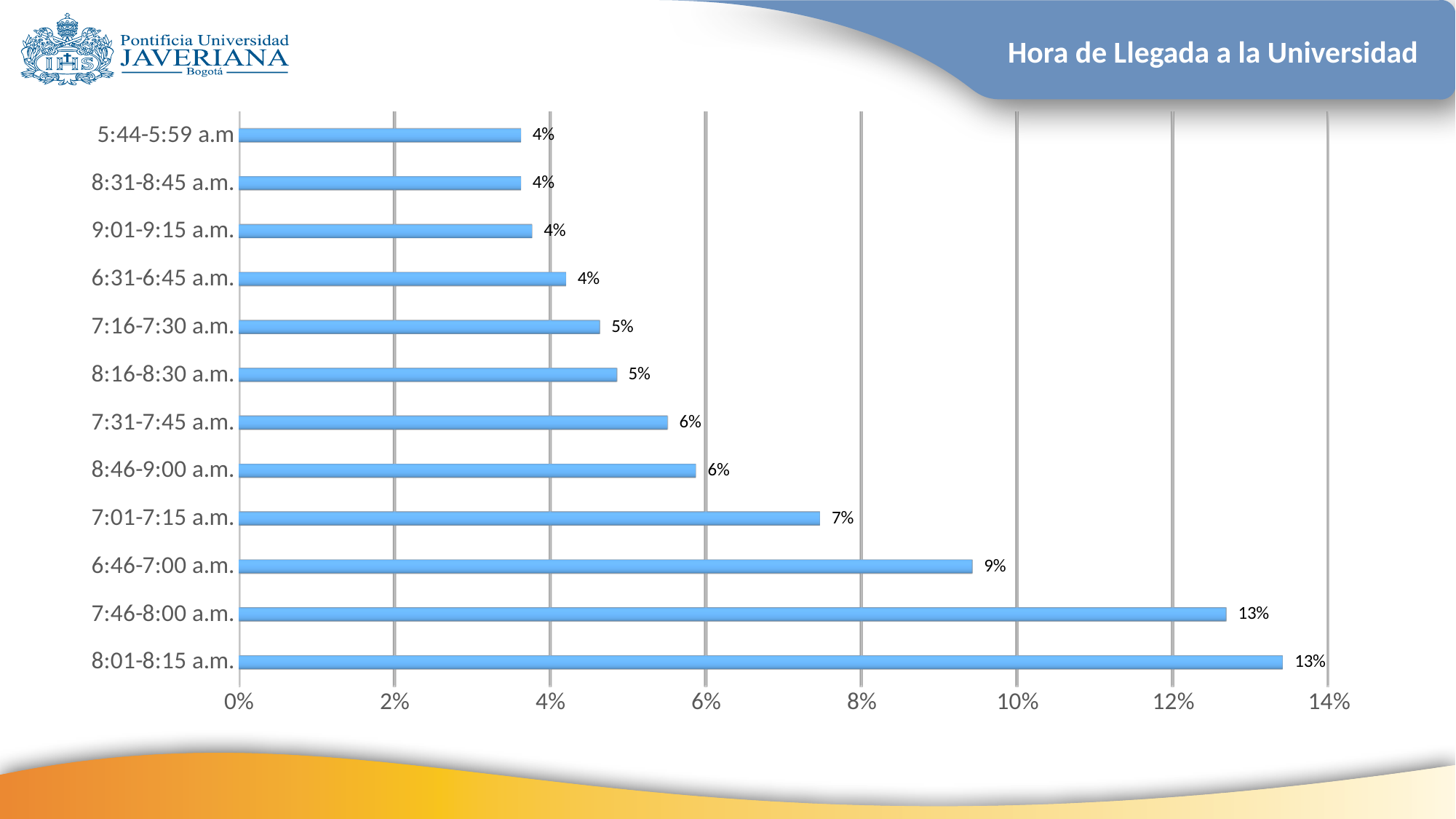
What is the value for 8:16-8:30 a.m.? 5% Is the value for 7:46-8:00 a.m. greater or less than 12%? greater What is the difference between the values for 6:46-7:00 a.m. and 7:01-7:15 a.m.? 2% What is the value for 7:31-7:45 a.m.? 6% How many time-interval categories are shown on the chart? 12 What kind of chart is shown on the slide? bar chart What is the value for 8:01-8:15 a.m.? 13% What is the value for 5:44-5:59 a.m? 4% What is the title shown on the slide for this chart? Hora de Llegada a la Universidad What is the value for 6:46-7:00 a.m.? 9% Which is larger, the value for 6:46-7:00 a.m. or the value for 8:46-9:00 a.m.? 6:46-7:00 a.m. What is the value for 7:01-7:15 a.m.? 7%